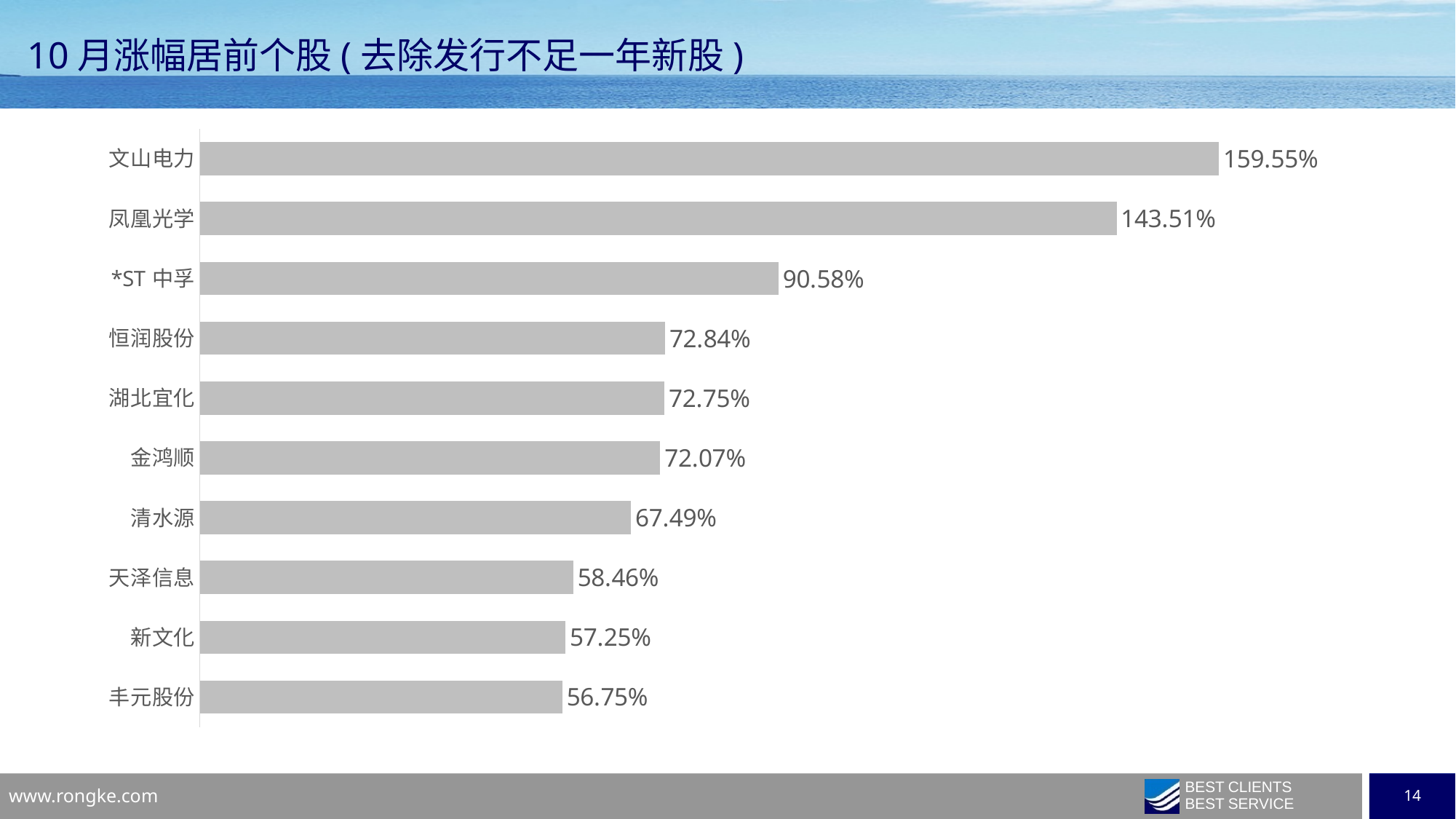
Which stock has the lowest value? 丰元股份 How many stocks are shown in the chart? 10 What is the value for *ST 中孚? 90.58% Which is larger, the value for *ST 中孚 or the value for 恒润股份? *ST 中孚 What kind of chart is shown on the slide? Bar chart What is the value for 清水源? 67.49% What is the difference between the values for 文山电力 and 凤凰光学? 16.04% What is the value for 丰元股份? 56.75% What is the value for 凤凰光学? 143.51% Which stock has the highest value? 文山电力 What is the value for 文山电力? 159.55% What is the title of the slide? 10 月涨幅居前个股 ( 去除发行不足一年新股 )